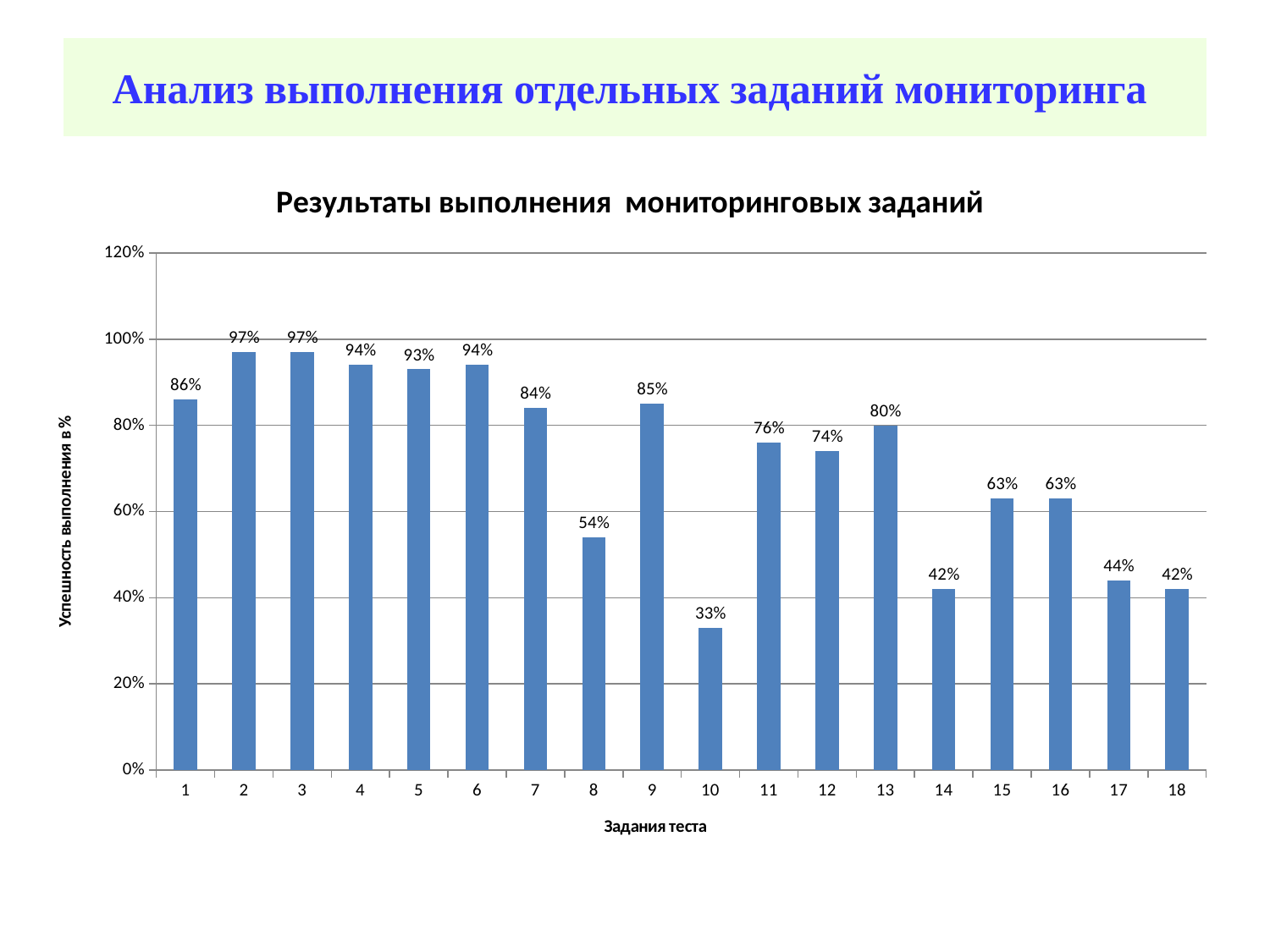
Which is larger, the value for task 11 or task 12? 11 What is the value for task 1? 86% What is the value for task 13? 80% What is the value for task 10? 33% What is the title of the chart? Результаты выполнения мониторинговых заданий How many tasks are shown on the x axis? 18 What kind of chart is this? bar chart What is the label of the x axis? Задания теста What is the difference between the values for task 2 and task 18? 55% Which task has the lowest value? 10 Is the value for task 7 greater or less than 80%? greater What is the difference between the values for task 9 and task 8? 31%